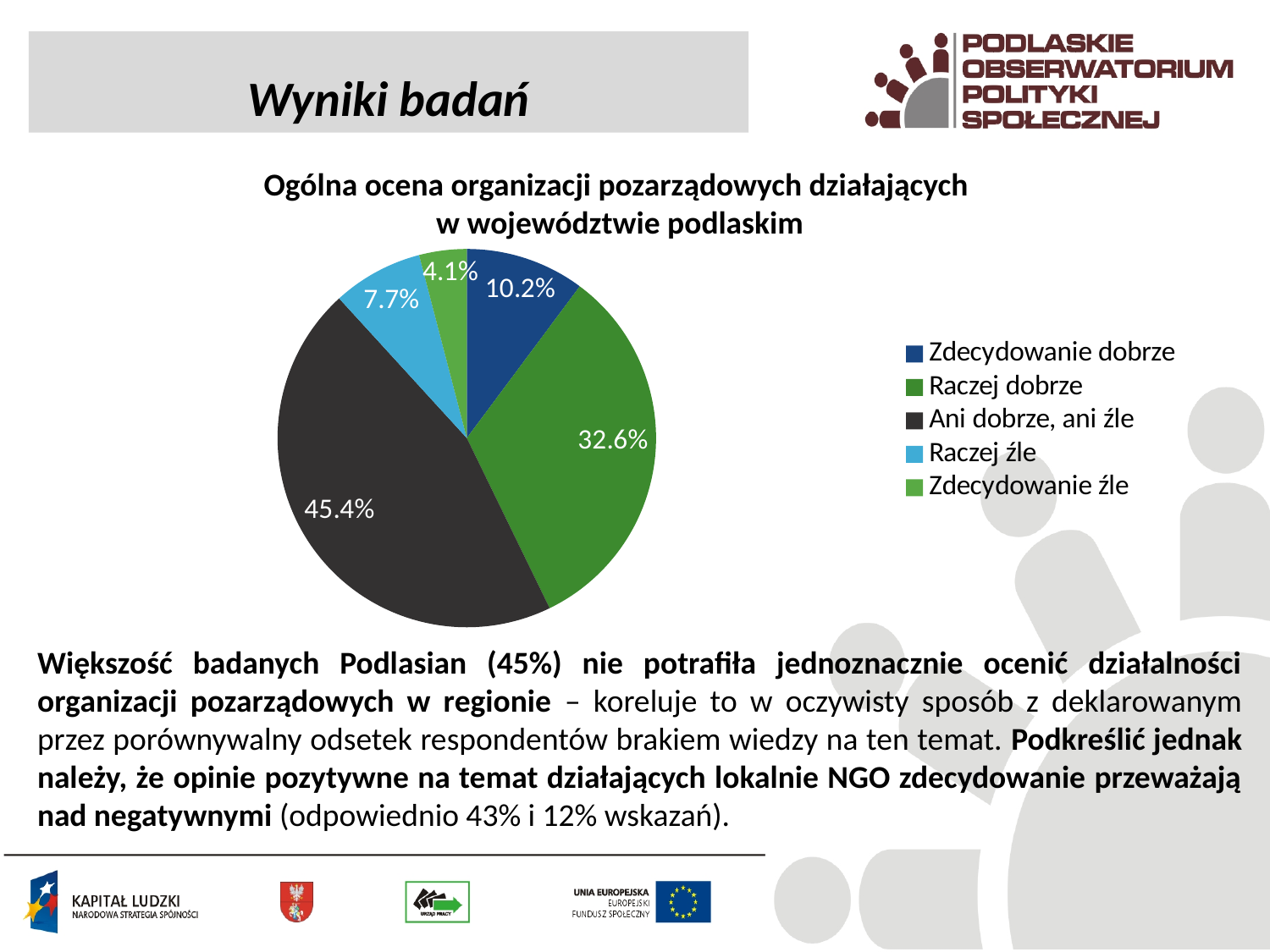
What kind of chart is shown on the slide? pie chart Which category has the smallest slice of the pie? Zdecydowanie źle What is the difference in percentage points between "Raczej dobrze" and "Zdecydowanie dobrze"? 22.4 What share of the pie is labelled "Zdecydowanie dobrze"? 10.2% What is the title of the chart? Ogólna ocena organizacji pozarządowych działających w województwie podlaskim Which is larger, the slice for "Raczej źle" or the slice for "Zdecydowanie dobrze"? Zdecydowanie dobrze What share of the pie is labelled "Ani dobrze, ani źle"? 45.4% Which category has the largest slice of the pie? Ani dobrze, ani źle What share of the pie is labelled "Raczej dobrze"? 32.6% How many categories does the legend list? 5 What share of the pie is labelled "Zdecydowanie źle"? 4.1% What share of the pie is labelled "Raczej źle"? 7.7%